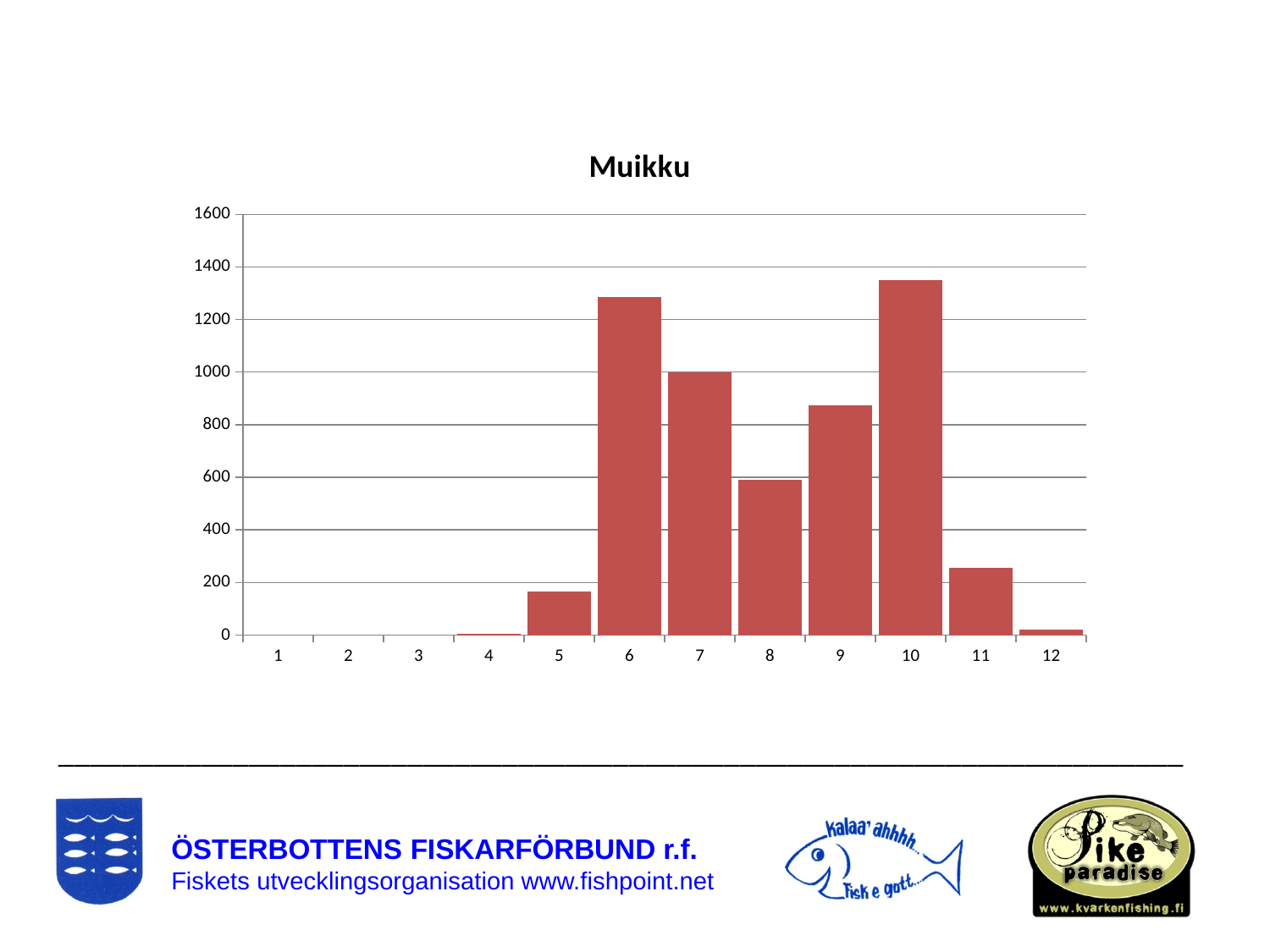
Which category has the highest bar in the chart? 10 Which has the larger value, category 8 or category 9? 9 Is the value for category 5 greater or less than 200? less What kind of chart is shown on the slide? bar chart Is the value for category 10 greater or less than 1200? greater Which has the larger value, category 6 or category 7? 6 Is the value for category 8 greater or less than 800? less What is the title of the chart? Muikku How many categories are shown on the x axis of the chart? 12 Do the values rise or fall from category 10 to category 12? fall Which has the larger value, category 5 or category 11? 11